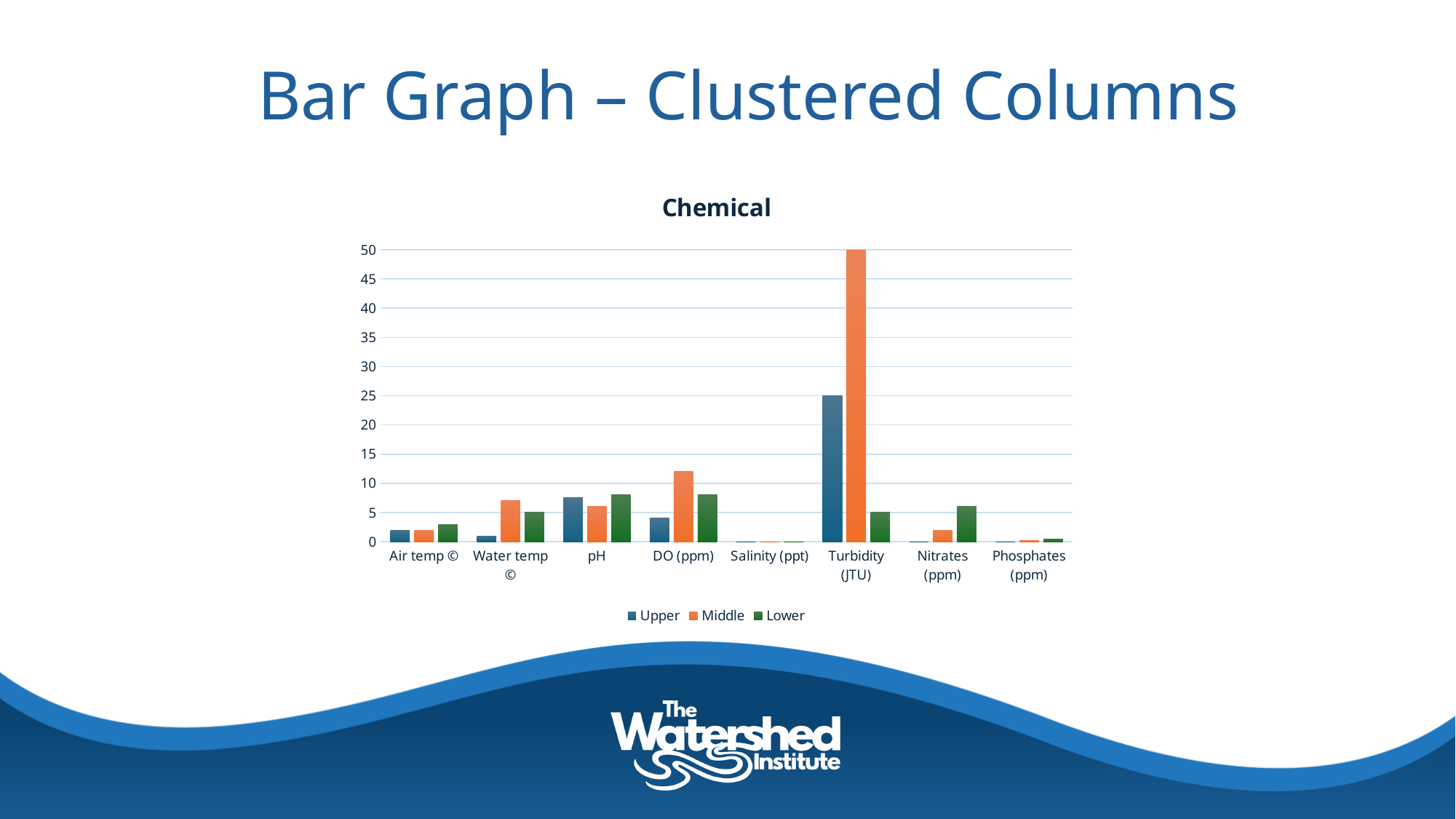
How many categories are shown along the x axis of the chart? 8 What is the Middle value for Turbidity (JTU)? 50 What is the title of the chart? Chemical What are the series names listed in the legend? Upper, Middle, Lower How many series does the legend list? 3 Is the Upper value for Water temp greater or less than 5? less Is the Middle value for DO (ppm) greater or less than 10? greater What kind of chart is shown on the slide? Bar chart For Turbidity (JTU), which is larger: the Middle value or the Lower value? Middle Which category has the highest Middle value? Turbidity (JTU) What is the difference between the Middle and Upper values for Turbidity (JTU)? 25 What is the Upper value for Turbidity (JTU)? 25